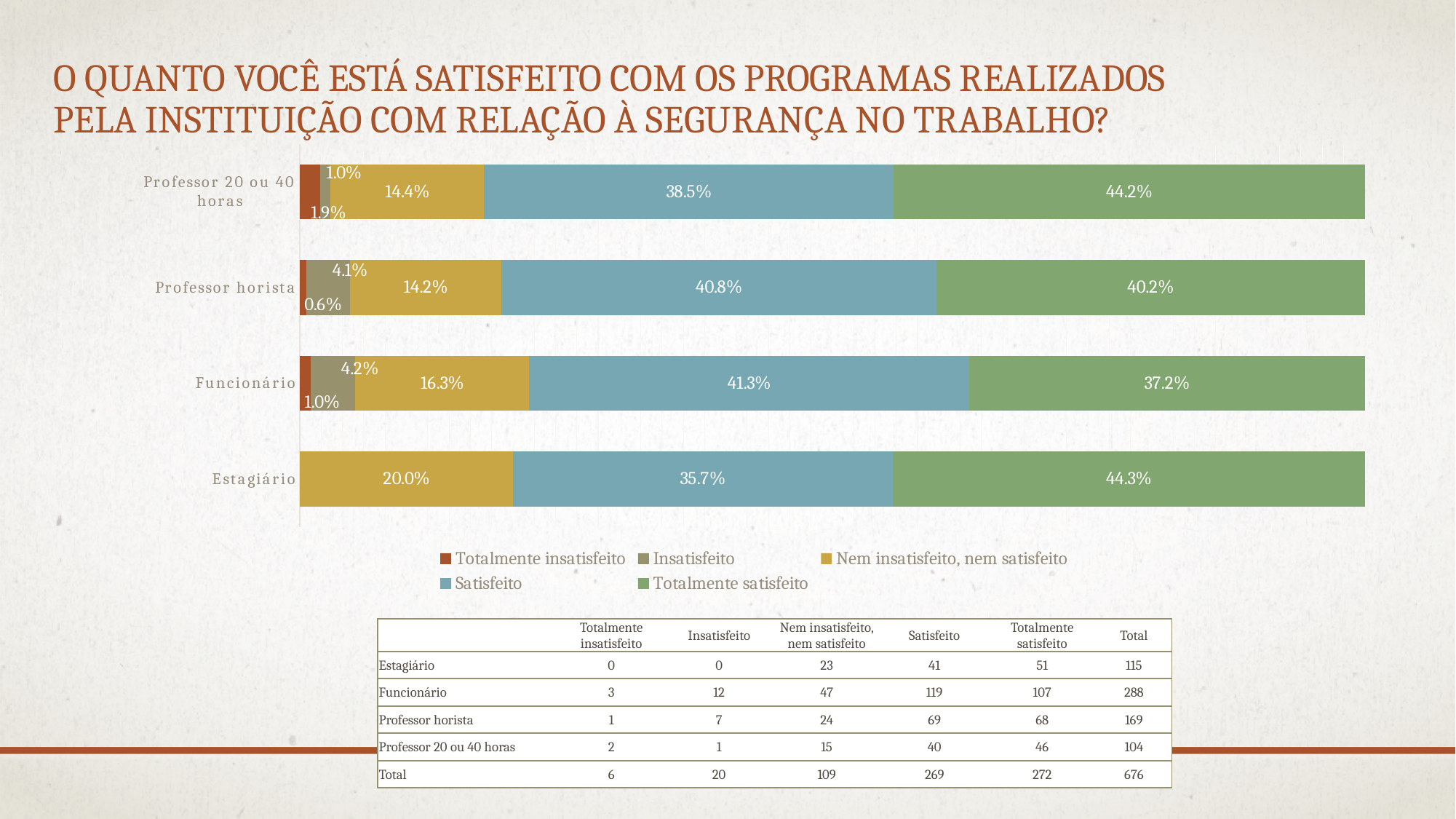
What is the difference between the 'Satisfeito' values for Funcionário and Estagiário? 5.6% Which colour represents the 'Satisfeito' series in the chart? Blue Which category has the lowest 'Totalmente satisfeito' share? Funcionário Which category has the highest 'Nem insatisfeito, nem satisfeito' share? Estagiário What is the 'Insatisfeito' value for Professor horista? 4.1% Which is larger: the 'Totalmente satisfeito' value for Professor 20 ou 40 horas or for Professor horista? Professor 20 ou 40 horas What is the 'Nem insatisfeito, nem satisfeito' value for Professor horista? 14.2% What is the 'Satisfeito' value for Funcionário? 41.3% How many series does the chart legend list? 5 How many categories (groups) are shown on the chart? 4 What is the 'Totalmente satisfeito' value for Estagiário? 44.3% What type of chart is shown on the slide? Stacked bar chart